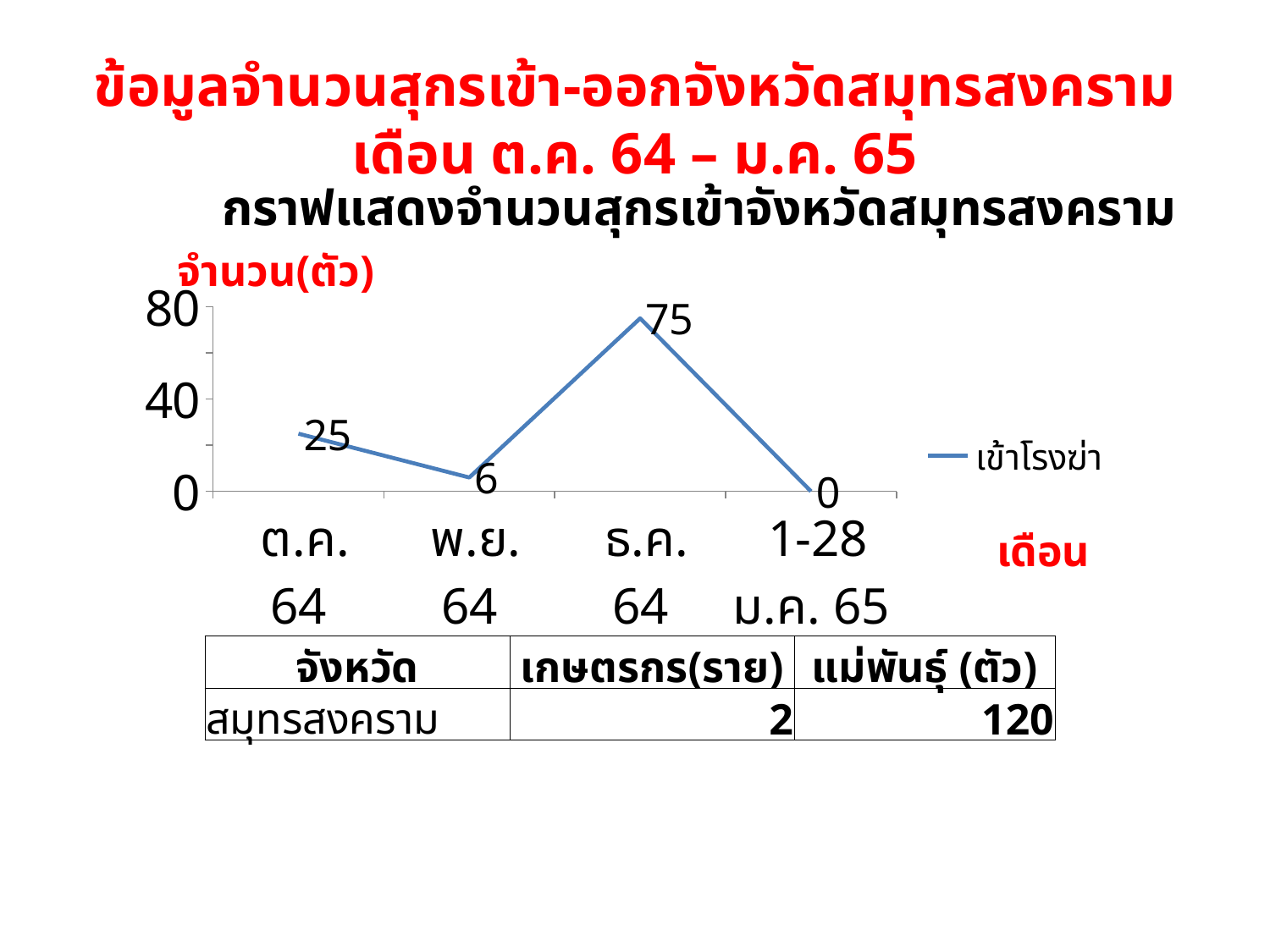
What is the value for พ.ย. 64? 6 What is the value for ต.ค. 64? 25 Which is larger, the value for ต.ค. 64 or the value for พ.ย. 64? ต.ค. 64 What is the difference between the values for ธ.ค. 64 and ต.ค. 64? 50 What is the name of the series in the legend? เข้าโรงฆ่า What is the value for 1-28 ม.ค. 65? 0 What kind of chart is shown? line chart Which month has the highest value? ธ.ค. 64 How many series does the legend list? 1 Which month has the lowest value? 1-28 ม.ค. 65 What is the value for ธ.ค. 64? 75 How many months are plotted on the x axis? 4